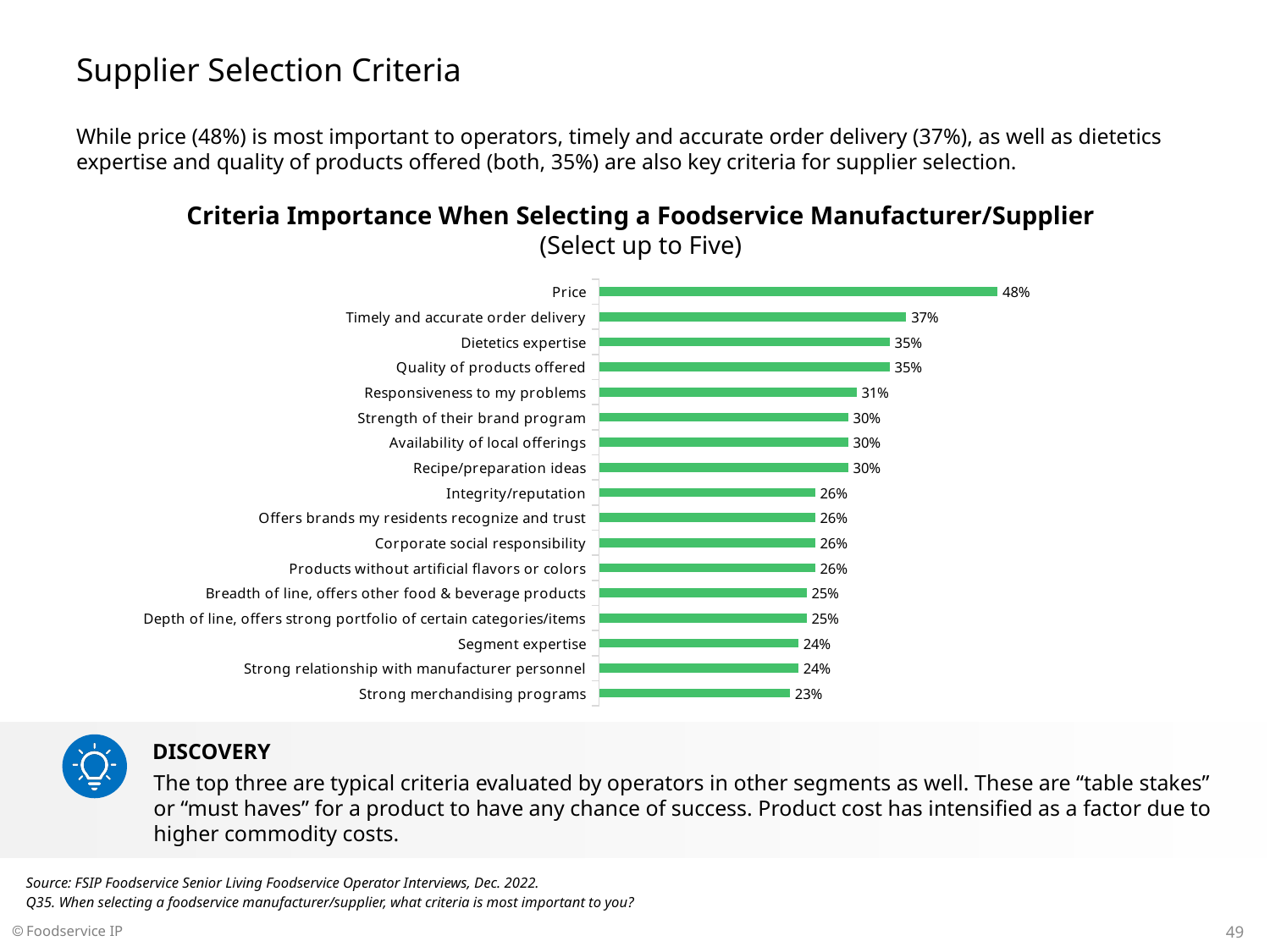
What is the value for Dietetics expertise? 35% What is the title of the chart? Criteria Importance When Selecting a Foodservice Manufacturer/Supplier Which is larger, the value for Integrity/reputation or the value for Segment expertise? Integrity/reputation What is the difference between the values for Price and Timely and accurate order delivery? 11% What is the value for Strong merchandising programs? 23% How many criteria are shown in the chart? 17 Which criterion has the lowest value? Strong merchandising programs What kind of chart is shown on the slide? Bar chart What is the difference between the values for Quality of products offered and Strong merchandising programs? 12% Which criterion has the highest value? Price What percentage of operators selected Price as an important criterion? 48% What is the value for Responsiveness to my problems? 31%